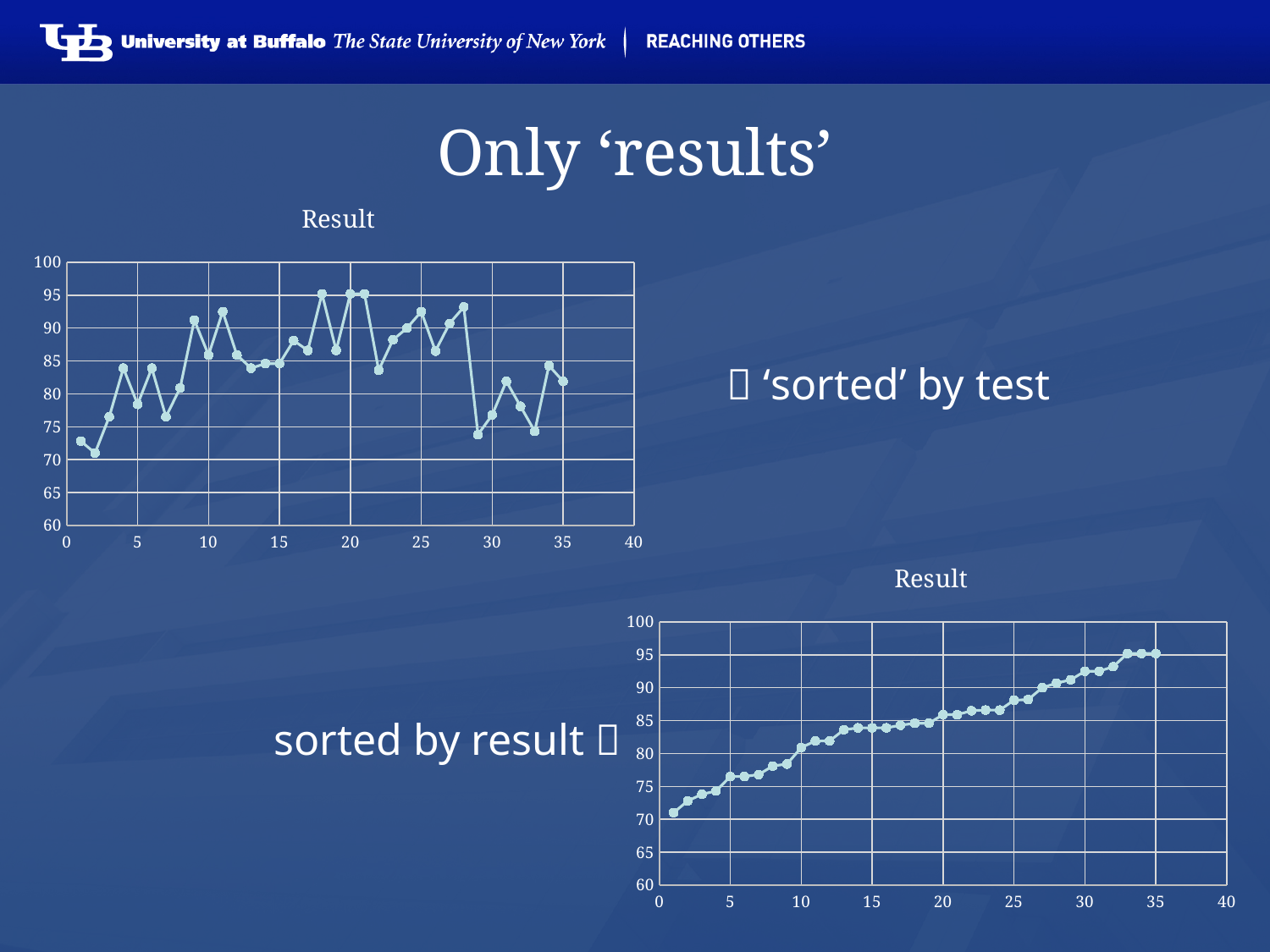
In the top-left chart, is the value at x = 2 greater or less than 75? less In the bottom-right chart, is the value at x = 1 greater or less than 75? less In the bottom-right chart, at which x value is the lowest point? 1 In the top-left chart, at which x value is the lowest point? 2 What is the title shown above each of the two charts? Result In the bottom-right chart, is the value at x = 35 greater or less than 90? greater In the bottom-right chart, do the values rise or fall as the x axis increases? rise What kind of chart is the top-left chart titled 'Result'? line chart In the top-left chart, which is larger: the value at x = 11 or the value at x = 13? x = 11